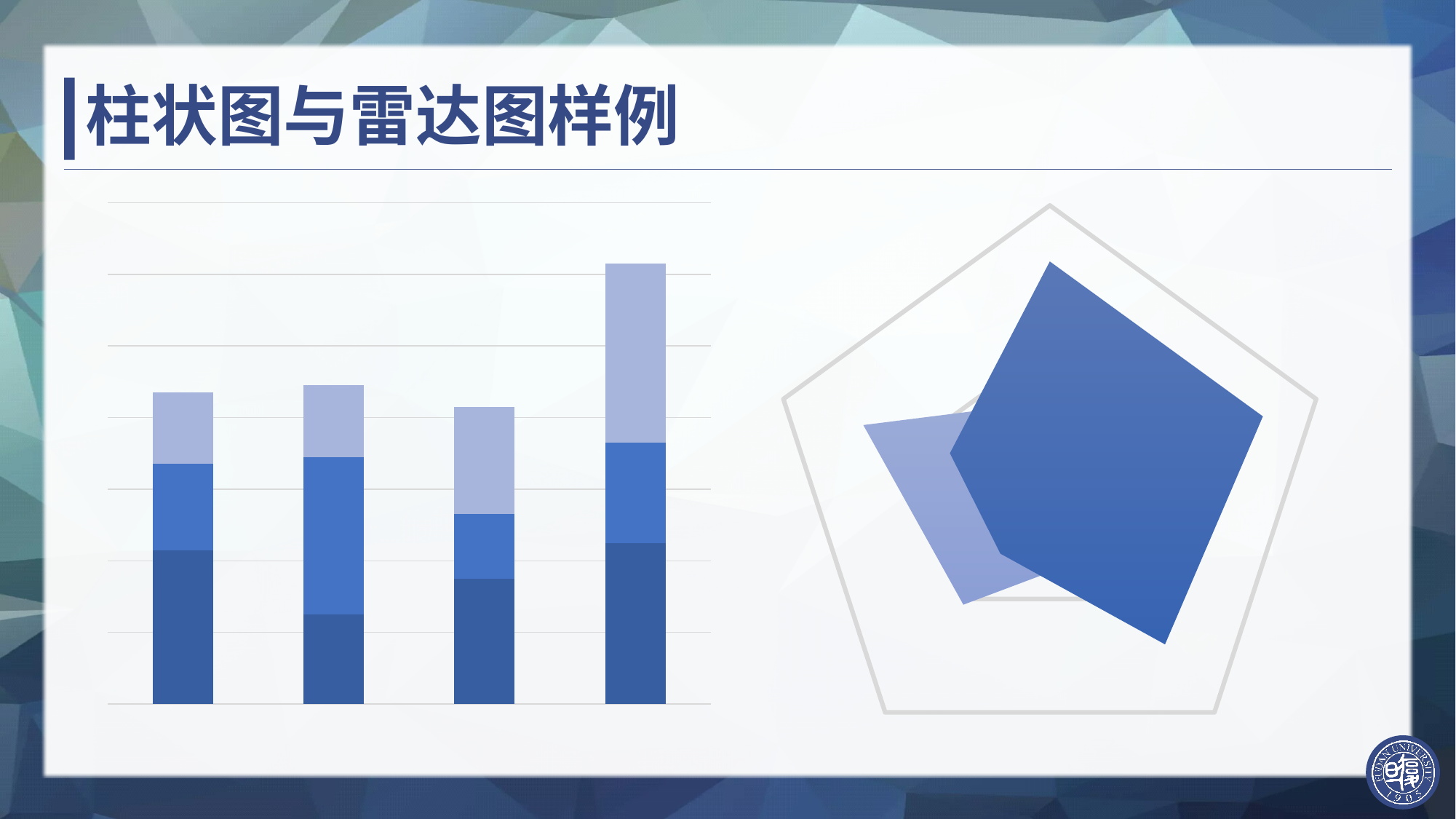
In the radar chart on the right, how many data series are plotted? 2 In the bar chart on the left, which bar is the tallest overall? The fourth (rightmost) bar In the bar chart on the left, which colour segment sits at the bottom of each bar? The dark blue segment Does the bar chart on the left display a legend? No In the bar chart on the left, how many bars are plotted? 4 In the bar chart on the left, is the rightmost bar taller or shorter than the leftmost bar? Taller In the radar chart on the right, which series covers the larger area, the dark blue one or the light blue one? The dark blue one What kind of chart is shown on the right side of the slide? A radar chart In the bar chart on the left, how many stacked segments (series) does each bar contain? 3 In the bar chart on the left, which is taller overall, the second bar or the third bar? The second bar In the radar chart on the right, how many axes (vertices) does the grid polygon have? 5 What kind of chart is shown on the left side of the slide? A stacked bar chart